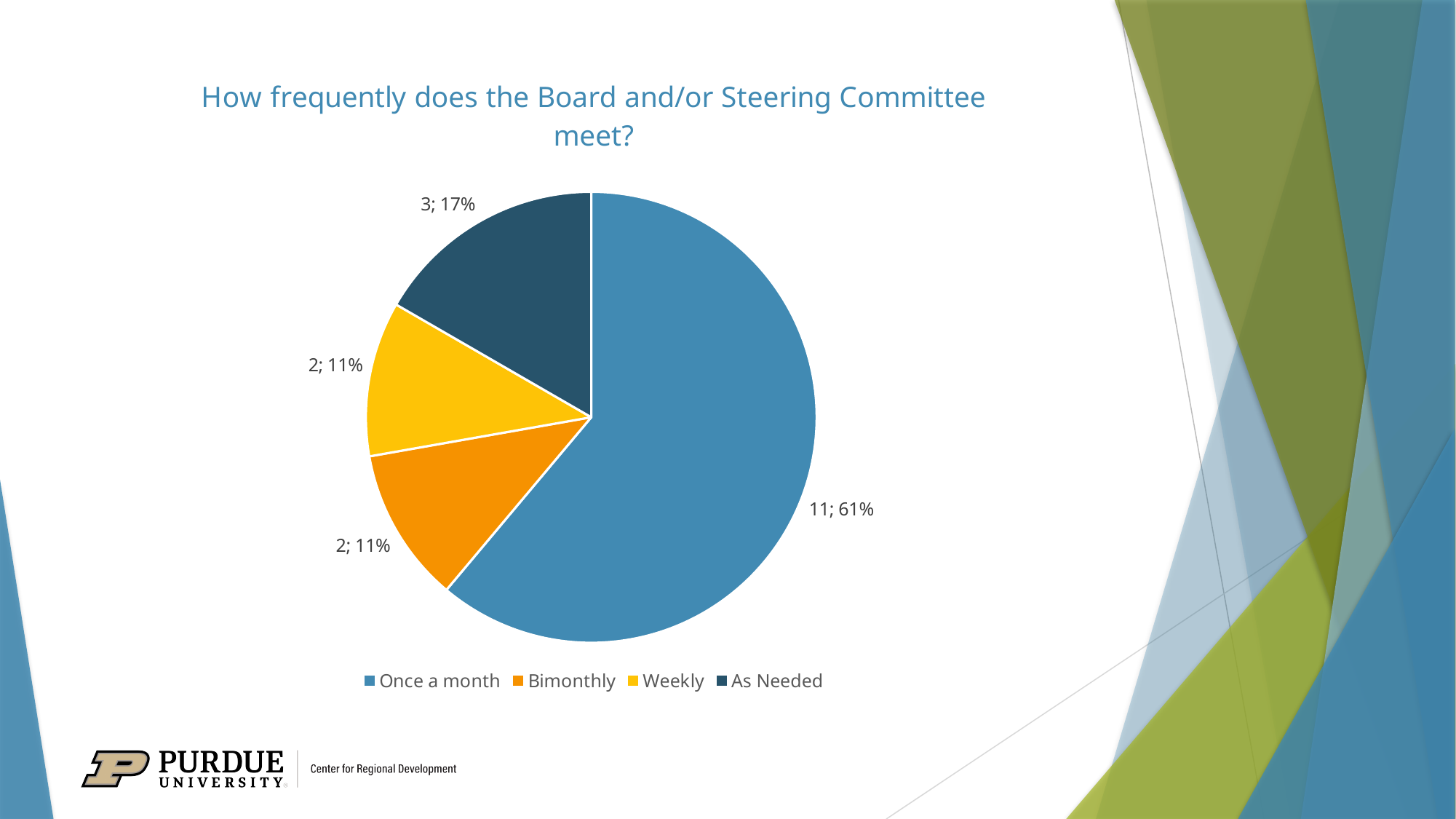
Which is larger, the 'As Needed' slice or the 'Bimonthly' slice? As Needed How many responses are in the 'As Needed' slice? 3 Which category has the largest slice? Once a month What is the difference in responses between 'Once a month' and 'As Needed'? 8 What kind of chart is shown on the slide? pie chart What is the total number of responses across all slices? 18 What percentage share does the 'Once a month' slice have? 61% How many responses are in the 'Weekly' slice? 2 What is the title of the chart? How frequently does the Board and/or Steering Committee meet? How many responses are in the 'Once a month' slice? 11 What percentage share does the 'As Needed' slice have? 17% How many categories does the legend list? 4